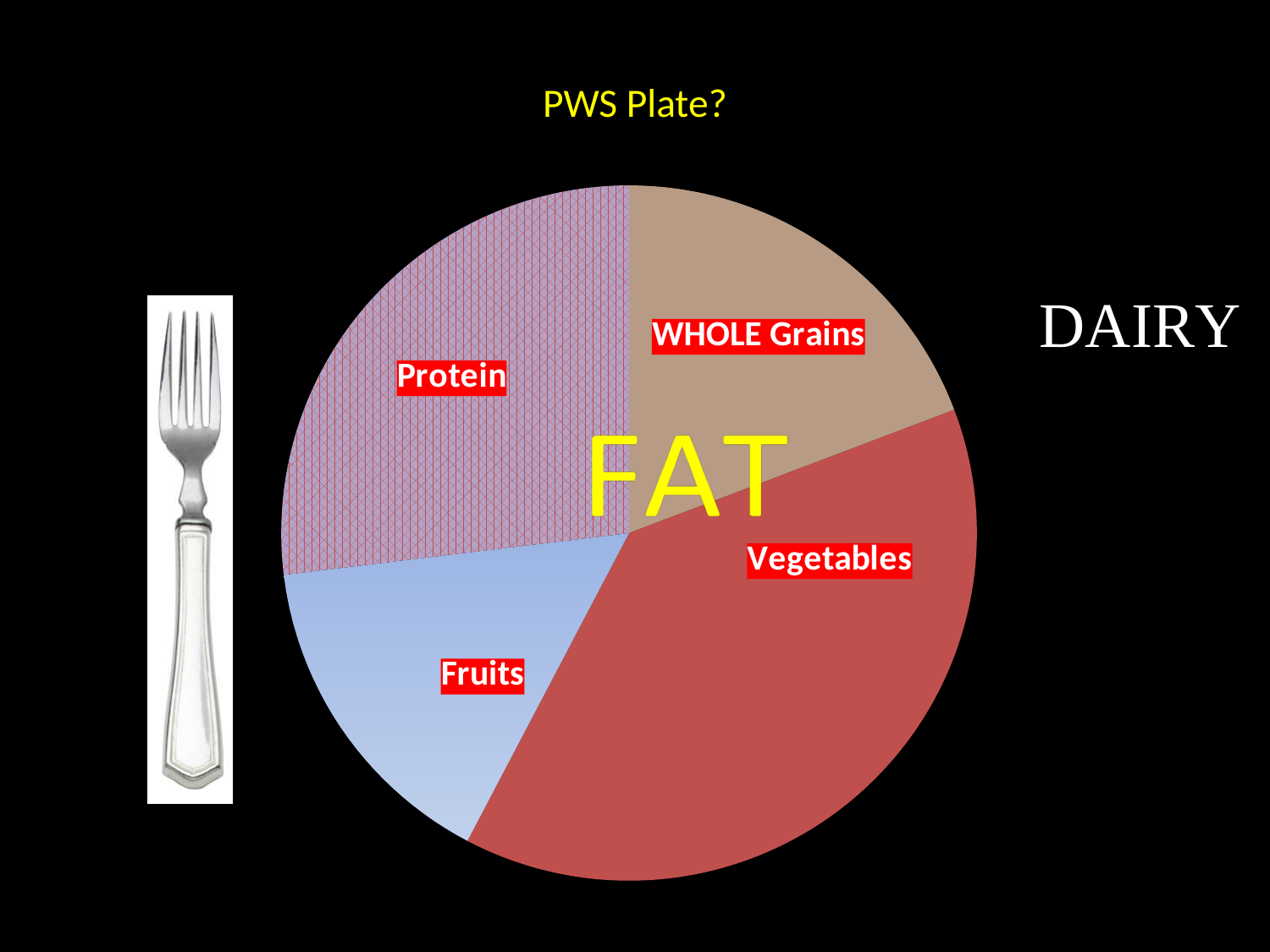
What is the title of the slide containing the pie chart? PWS Plate? Which slice is larger, WHOLE Grains or Fruits? WHOLE Grains How many labelled slices does the pie chart have? 4 Which slice is larger, Protein or WHOLE Grains? Protein Which slice of the pie chart is the largest? Vegetables Which slice is larger, Vegetables or Fruits? Vegetables Which slice of the pie chart is the smallest? Fruits Which slice of the pie chart is coloured light blue? Fruits What kind of chart is shown on the slide? pie chart